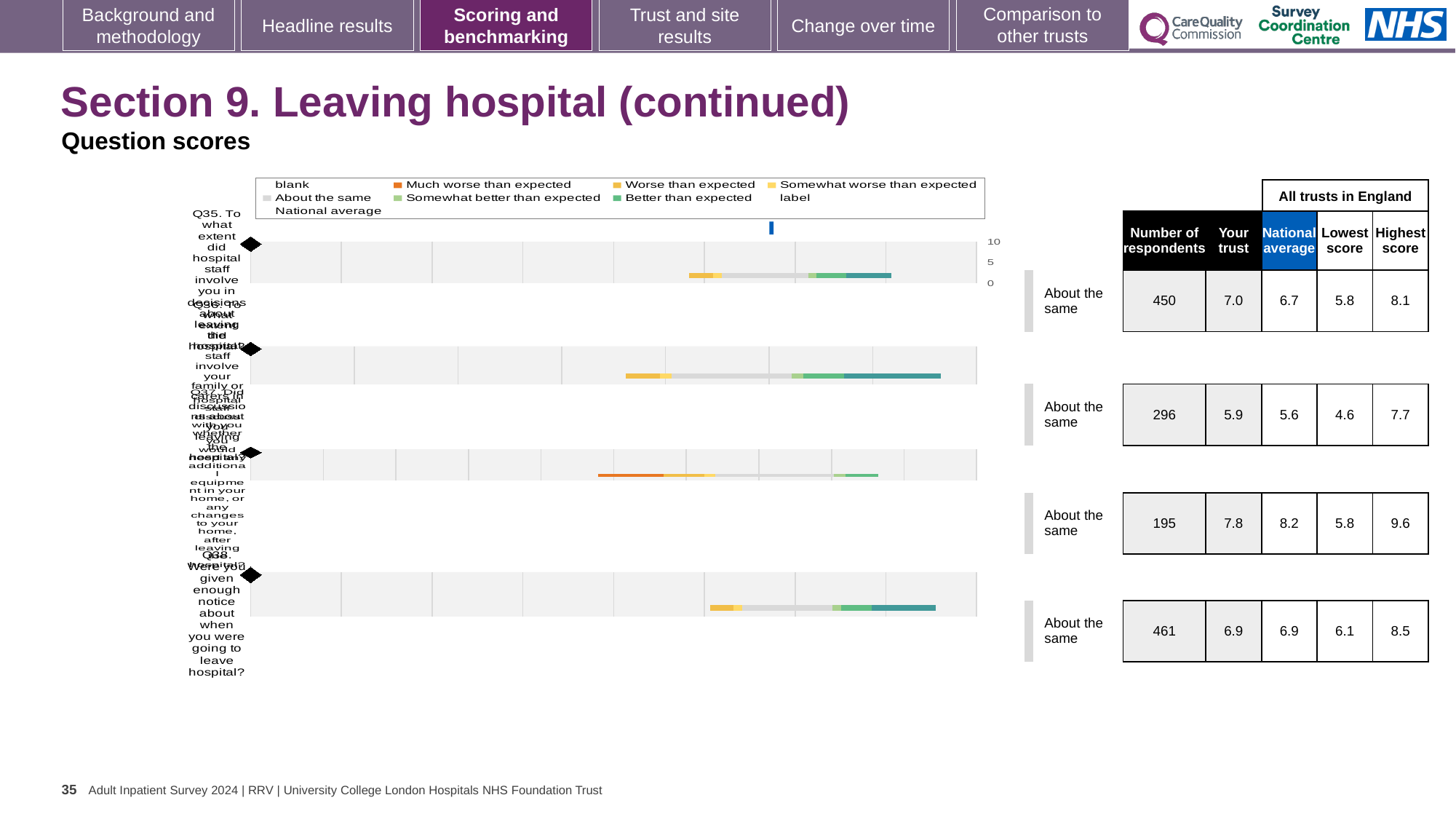
What is the national average for Q35 (the first row)? 6.7 What is the highest score among all trusts in England for Q38 (the last row)? 8.5 Which row has the lowest 'Your trust' score? the second row (296 respondents), 5.9 How many question bars are plotted in the chart? 4 What is the 'Your trust' score for Q35 (the first row, 450 respondents)? 7.0 For the third row (195 respondents), which is larger: the 'Your trust' score or the national average? national average Which row has the highest 'Your trust' score? the third row (195 respondents), 7.8 What kind of chart is shown on the slide? bar chart For Q38 (the last row), what is the difference between the highest score and the lowest score? 2.4 What benchmark category is shown next to each of the four question bars? About the same For Q35 (the first row), what is the difference between the 'Your trust' score and the national average? 0.3 How many respondents answered Q38 (the last row)? 461